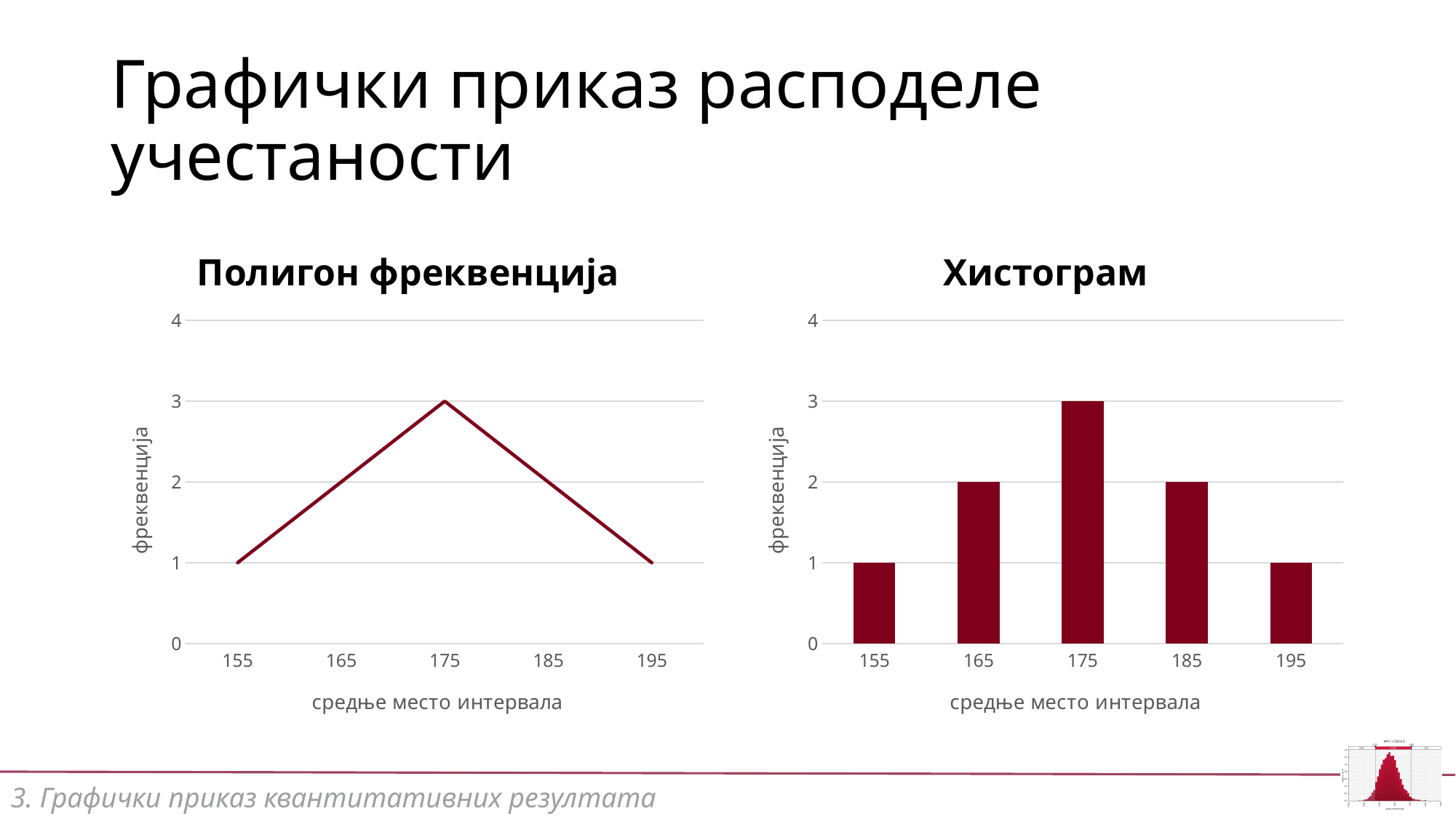
In the chart titled "Хистограм", which interval midpoint has the highest frequency? 175 In the chart titled "Полигон фреквенција", do the values rise or fall from 155 to 175? rise How many interval midpoints are shown on the x axis of the chart titled "Хистограм"? 5 What is the x-axis label of the chart titled "Полигон фреквенција"? средње место интервала In the chart titled "Хистограм", what is the frequency for 155? 1 What kind of chart is the chart titled "Полигон фреквенција"? line chart In the chart titled "Хистограм", what is the frequency for 175? 3 What is the y-axis label of the chart titled "Хистограм"? фреквенција What kind of chart is the chart titled "Хистограм"? bar chart In the chart titled "Полигон фреквенција", what is the frequency at 185? 2 In the chart titled "Полигон фреквенција", what is the difference between the frequency at 175 and the frequency at 195? 2 In the chart titled "Хистограм", which is larger, the frequency for 165 or the frequency for 195? 165